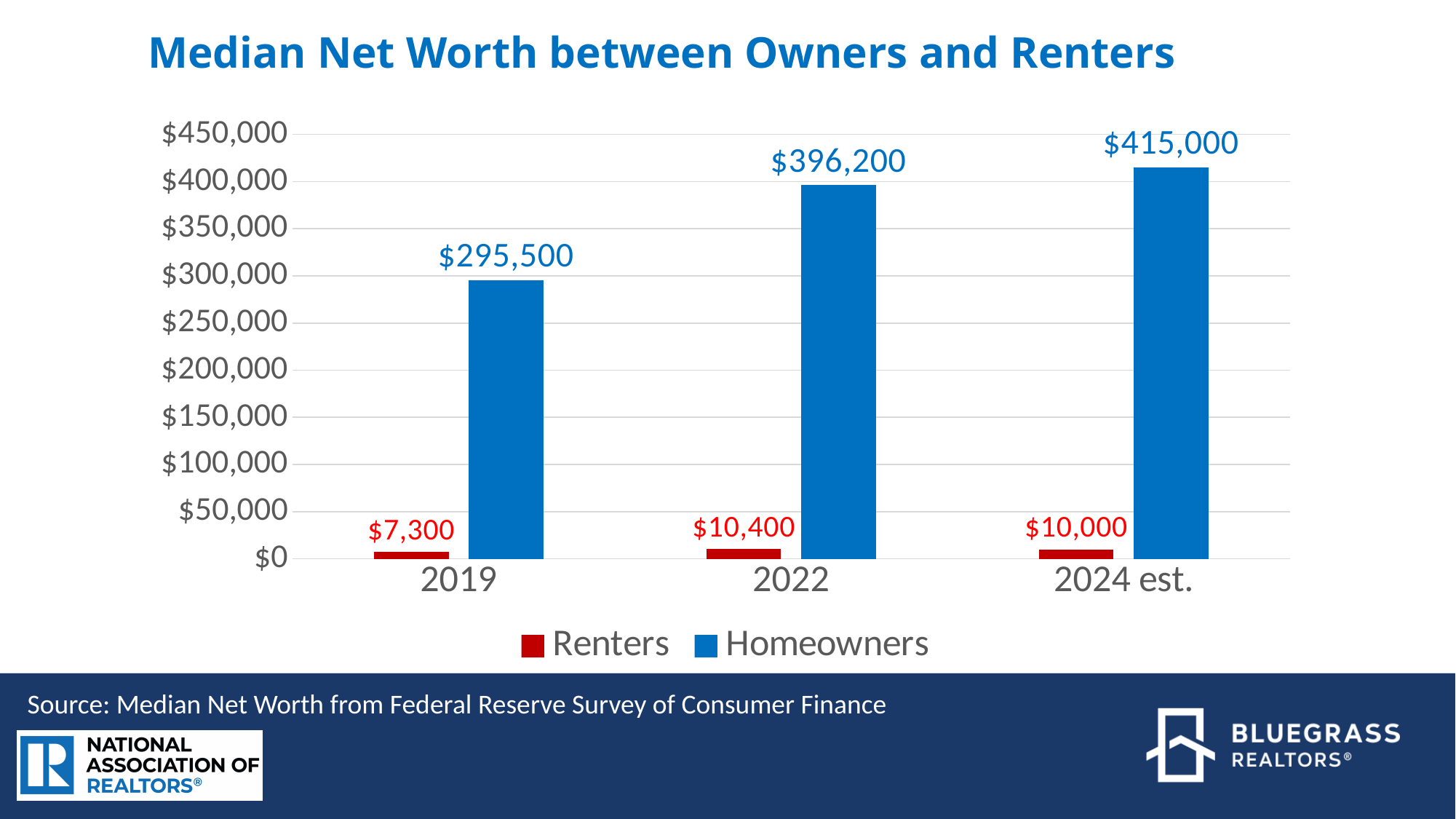
How many years are shown on the x axis? 3 What kind of chart is shown on the slide? Bar chart What is the median net worth for Homeowners in 2019? $295,500 By how much did the Homeowners median net worth increase from 2019 to 2022? $100,700 What is the median net worth for Renters in 2019? $7,300 How many series does the legend list? 2 What is the median net worth for Homeowners in 2024 est.? $415,000 Which is larger, the Renters median net worth in 2022 or in 2024 est.? 2022 What is the median net worth for Renters in 2022? $10,400 In which year is the Homeowners median net worth highest? 2024 est. What is the difference between the Homeowners and Renters median net worth in 2022? $385,800 In which year is the Renters median net worth lowest? 2019